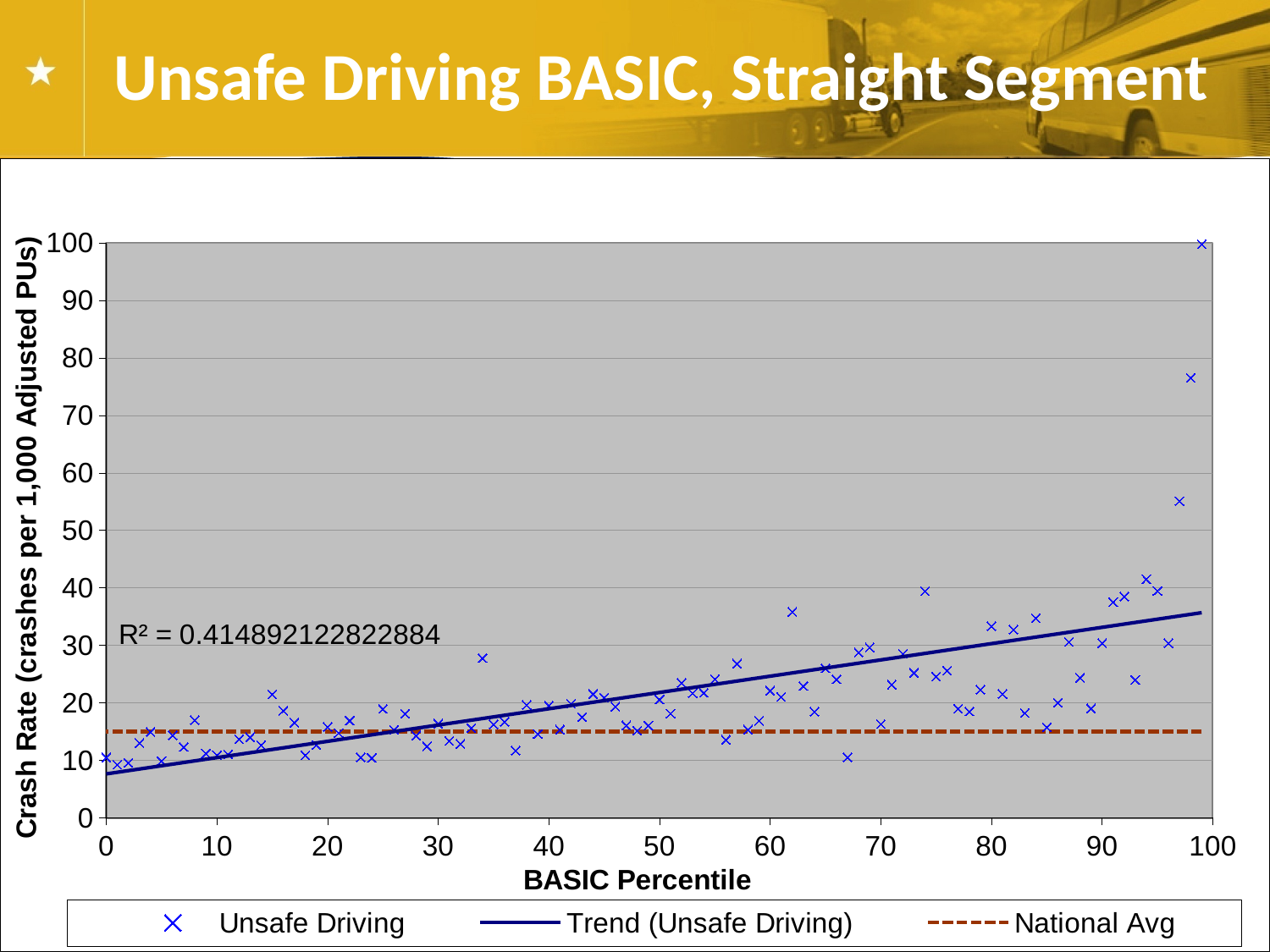
Does the trend line for Unsafe Driving rise or fall as the BASIC Percentile increases? rises Is the National Avg line greater or less than 20 crashes per 1,000 Adjusted PUs? less Is the National Avg line greater or less than 10 crashes per 1,000 Adjusted PUs? greater What kind of chart is shown on the slide? scatter chart What is the maximum value shown on the y axis? 100 Is the trend line value at a BASIC Percentile of 0 greater or less than 10? less What is the title of the x axis? BASIC Percentile How many series does the legend list? 3 What is the title of the chart slide? Unsafe Driving BASIC, Straight Segment What R² value is printed on the chart? R² = 0.414892122822884